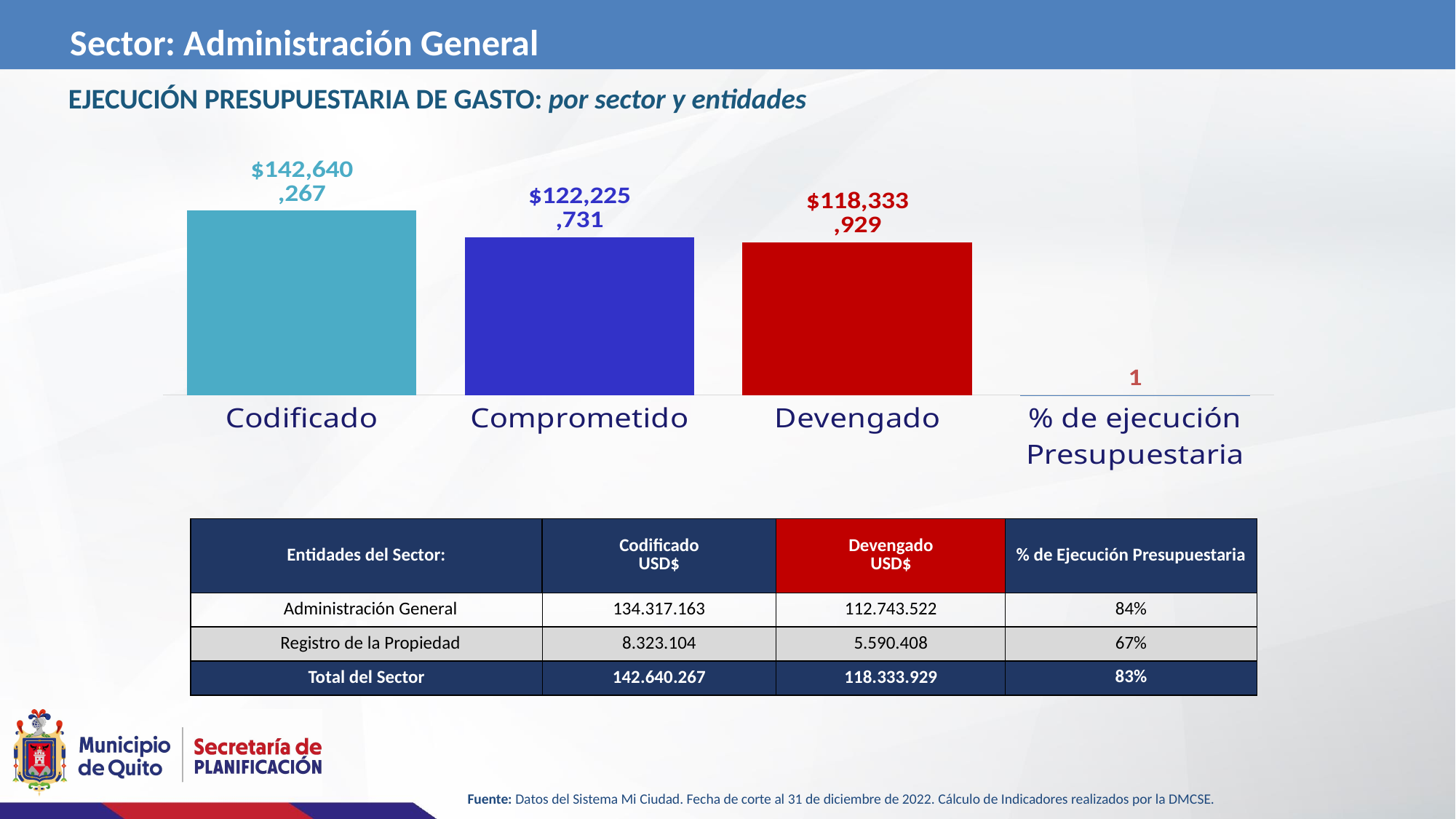
What value is printed for the '% de ejecución Presupuestaria' category in the chart? 1 What is the difference between the Codificado and Comprometido values in the bar chart? $20,414,536 Which of the three dollar-value categories in the bar chart has the highest value? Codificado What is the value shown for Comprometido in the bar chart? $122,225,731 What is the difference between the Comprometido and Devengado values in the bar chart? $3,891,802 What type of chart is shown on the slide? Bar chart Which of the three dollar-value categories in the bar chart has the lowest value? Devengado What is the value shown for Devengado in the bar chart? $118,333,929 What is the value shown for Codificado in the bar chart? $142,640,267 How many categories are shown on the x axis of the bar chart? 4 What colour is the Devengado bar in the chart? Red Which is larger in the bar chart, Comprometido or Devengado? Comprometido